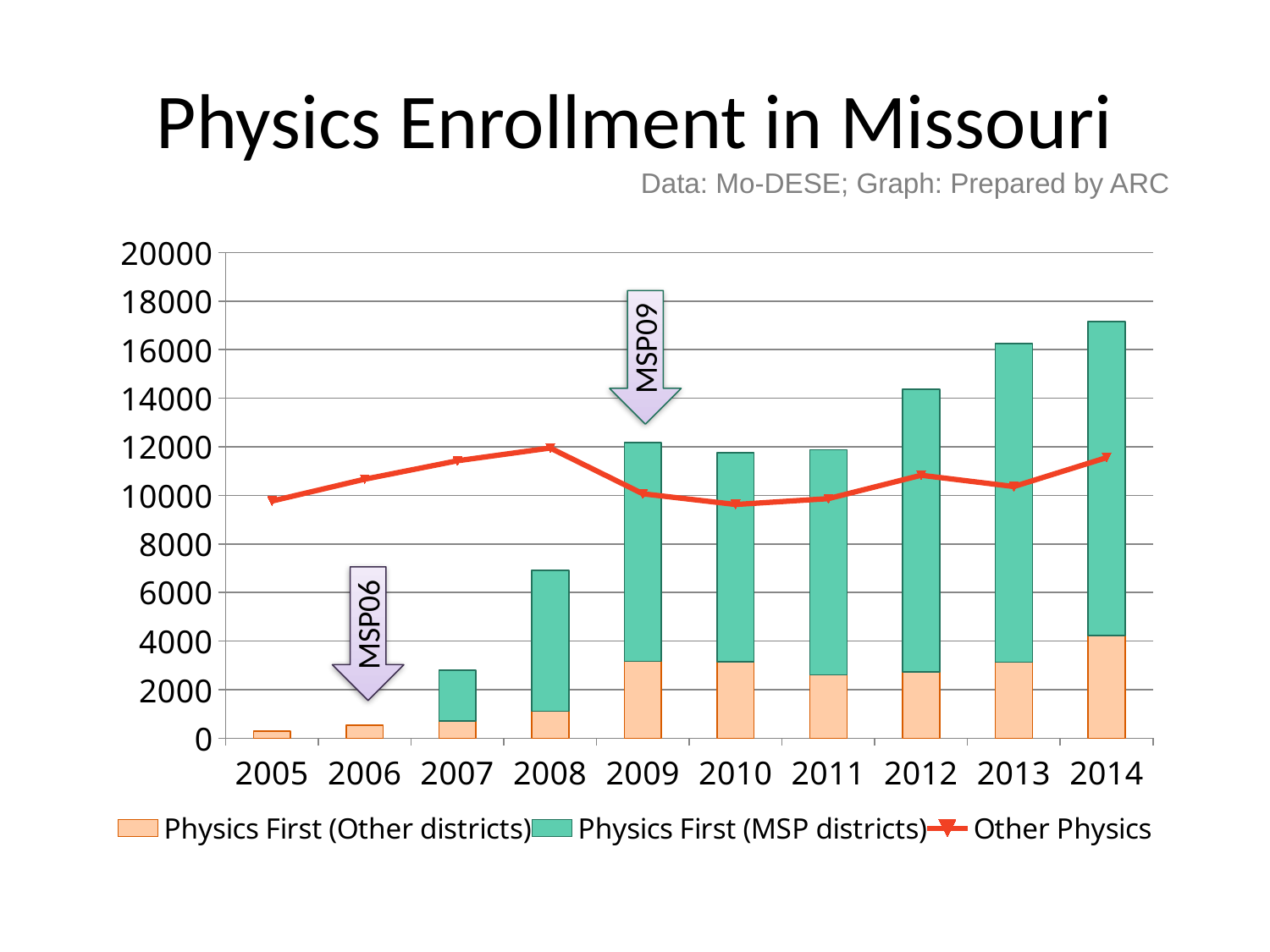
Do the stacked bar totals generally rise or fall from 2005 to 2014? rise Is the total height of the stacked bar for 2008 greater or less than 8000? less What labels are written on the two arrows pointing at the chart? MSP06 and MSP09 Is the Other Physics value for 2008 greater or less than 10000? greater What kind of chart is shown on the slide? A stacked bar chart with a line series How many years are shown along the x axis? 10 Is the Other Physics value for 2010 greater or less than 10000? less How many series does the legend list? 3 Which year has the tallest stacked bar (largest total Physics First enrollment)? 2014 Which year has the larger total stacked bar, 2012 or 2013? 2013 Which year has the shortest stacked bar (smallest total Physics First enrollment)? 2005